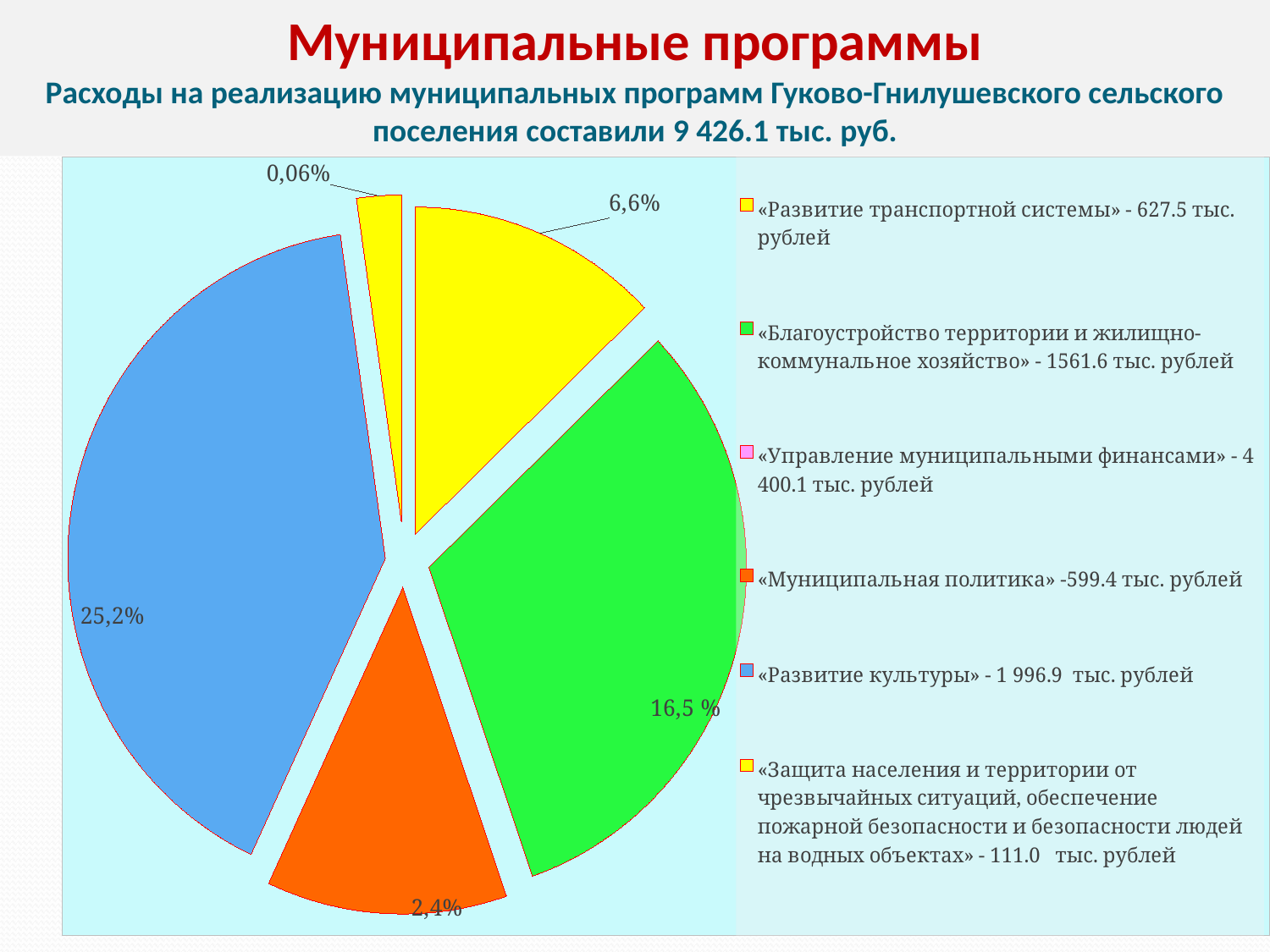
According to the slide subtitle, what was the total spending on municipal programmes? 9 426.1 тыс. руб. According to the legend, what amount is given for «Развитие культуры»? 1 996.9 тыс. рублей What percentage label is shown on the orange slice of the pie chart? 2,4% According to the legend, which programme has the smallest amount? «Защита населения и территории от чрезвычайных ситуаций, обеспечение пожарной безопасности и безопасности людей на водных объектах» According to the legend, which programme has the largest amount? «Управление муниципальными финансами» What colour represents «Муниципальная политика» in the pie chart? orange What percentage label is shown on the blue slice of the pie chart? 25,2% What percentage label is shown on the green slice of the pie chart? 16,5 % What kind of chart is shown on the slide? pie chart How many entries does the legend of the pie chart list? 6 What is the difference between the legend amounts for «Благоустройство территории и жилищно-коммунальное хозяйство» and «Развитие транспортной системы»? 934.1 тыс. рублей Which has the larger amount in the legend: «Развитие транспортной системы» or «Муниципальная политика»? «Развитие транспортной системы»